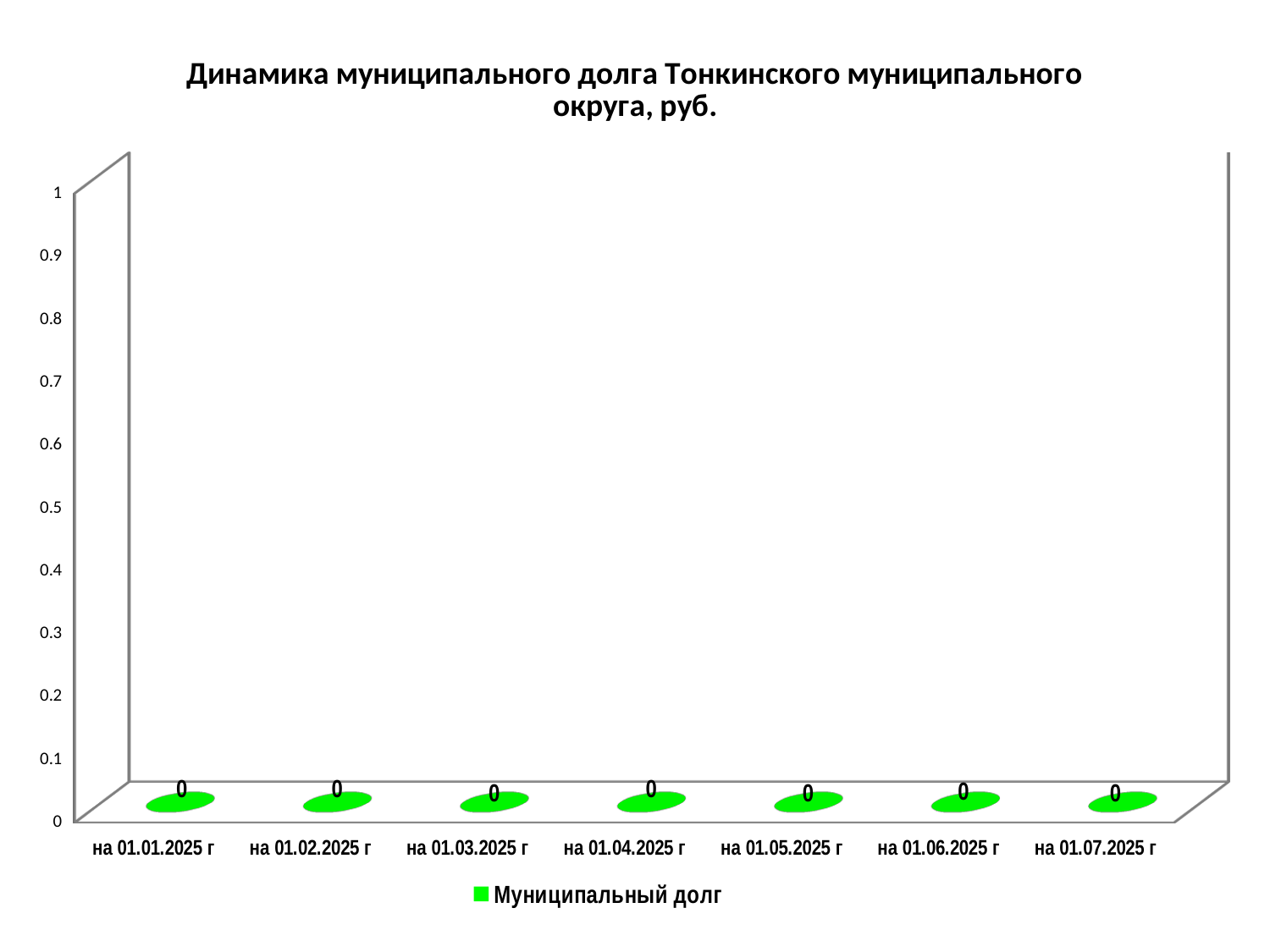
What kind of chart is this? bar chart What is the difference between the values for "на 01.02.2025 г" and "на 01.06.2025 г"? 0 What is the value for "на 01.07.2025 г"? 0 What is the value for "на 01.01.2025 г"? 0 What is the value for "на 01.04.2025 г"? 0 What is the name of the series shown in the legend? Муниципальный долг How many dates (categories) are shown on the x axis? 7 Do the values rise, fall, or stay the same from 01.01.2025 to 01.07.2025? stay the same How many series does the legend list? 1 Is the value for "на 01.05.2025 г" greater or less than 0.5? less What colour are the bars in the chart? green